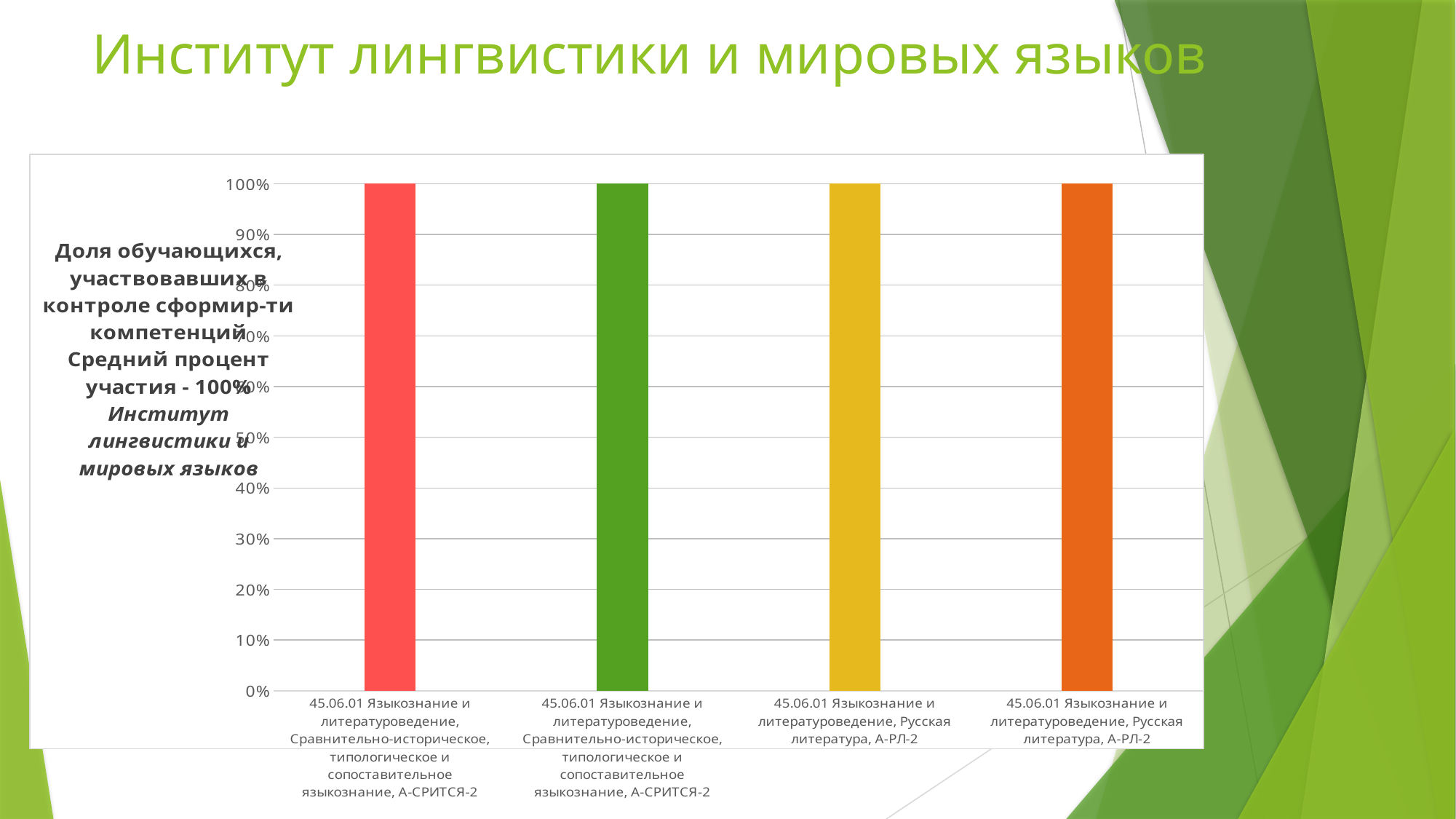
Is the value of the green bar greater or less than 50%? greater Do the bar values rise, fall, or stay the same from left to right? Stay the same What is the highest value shown on the vertical axis? 100% How many bars are labelled with the programme 'Русская литература, А-РЛ-2'? 2 According to the chart's title text, what is the average participation percentage (Средний процент участия)? 100% How many bars are plotted in the chart? 4 What kind of chart is shown on the slide? Bar chart Is the value of the orange bar greater or less than 90%? greater What value does the last (orange) bar on the right reach? 100% What is the difference between the value of the red bar and the value of the green bar? 0% What value does the third (yellow) bar, for 45.06.01 Языкознание и литературоведение, Русская литература, А-РЛ-2, reach? 100% What value does the first (red) bar, for 45.06.01 Языкознание и литературоведение, А-СРИТСЯ-2, reach? 100%